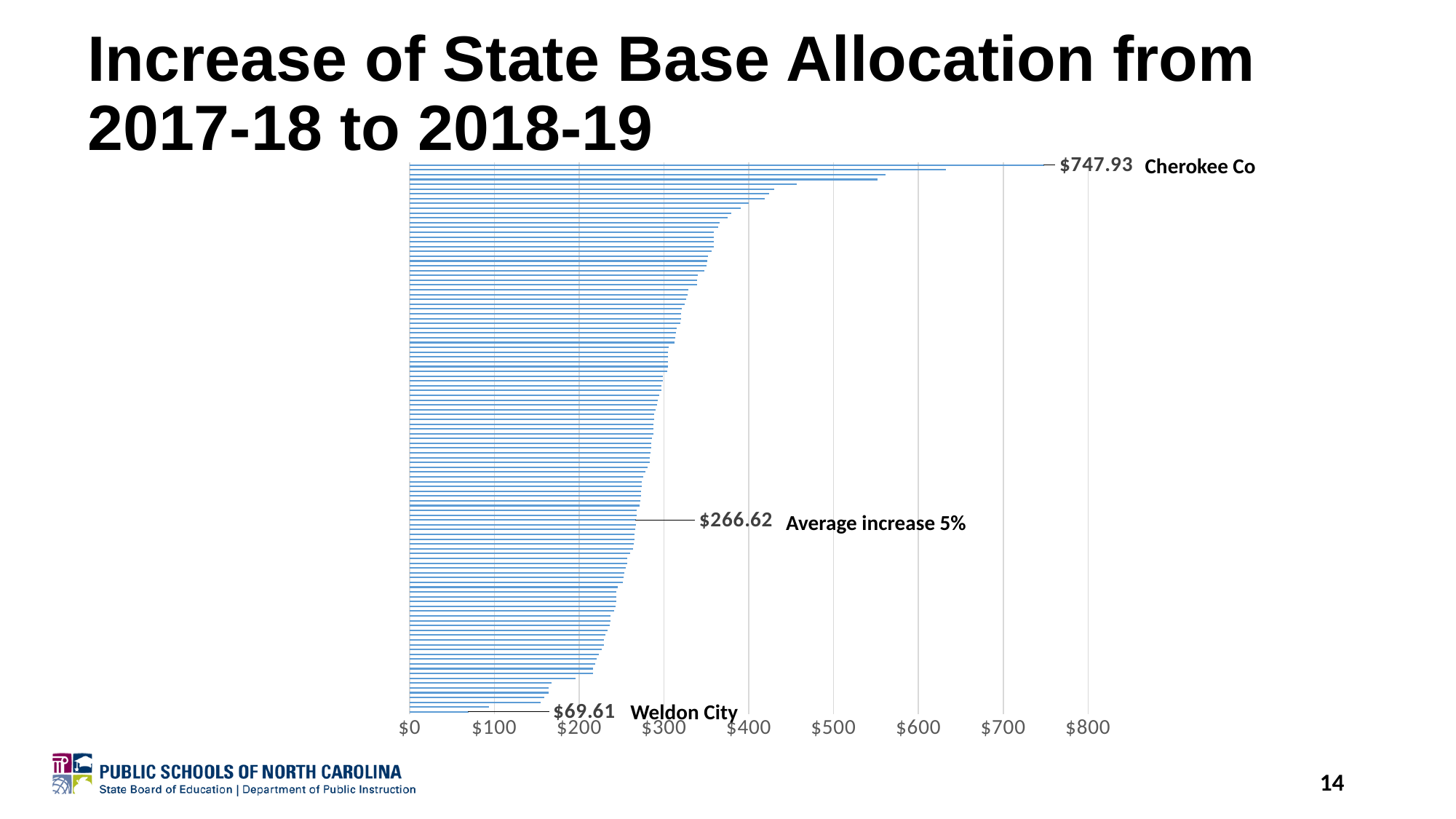
What is the increase in state base allocation for Weldon City? $69.61 What kind of chart is shown on the slide? bar chart Which district has the lowest increase in state base allocation? Weldon City Which district has the highest increase in state base allocation? Cherokee Co Is the value for Cherokee Co greater or less than $700? greater How much larger is the increase for Cherokee Co than for Weldon City? $678.32 Which has the larger increase, Cherokee Co or Weldon City? Cherokee Co By how much does Cherokee Co's increase exceed the average increase of $266.62? $481.31 What percentage is given for the average increase on the chart? 5% What dollar value is labeled as the average increase on the chart? $266.62 How much lower is Weldon City's increase than the average increase of $266.62? $197.01 What is the increase in state base allocation for Cherokee Co? $747.93